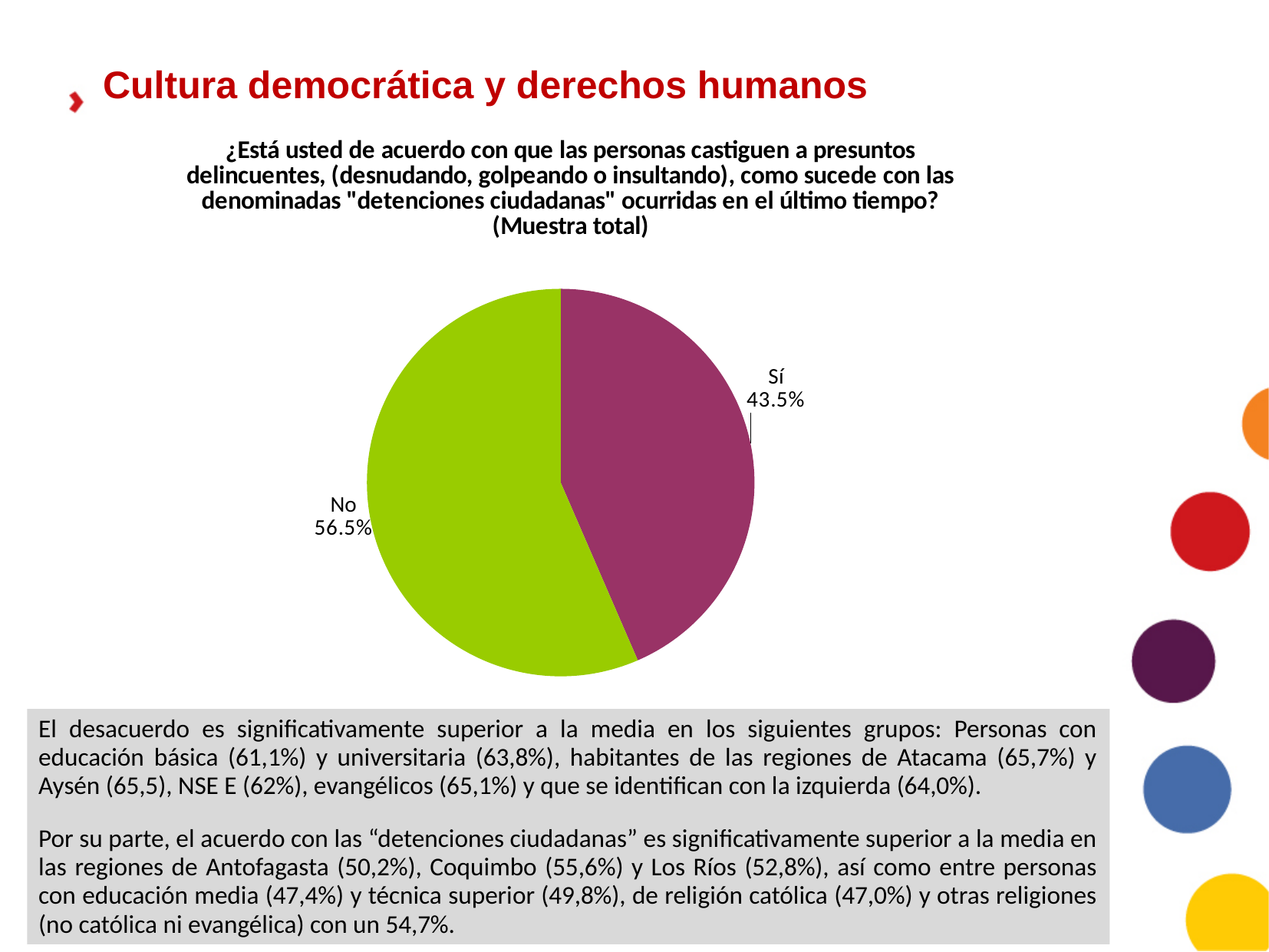
Is the value for "No" greater or less than 50%? greater What type of chart is shown on the slide? Pie chart How many slices does the pie chart have? 2 What percentage of respondents answered "Sí"? 43.5% Is the share for "Sí" larger or smaller than the share for "No"? Smaller Which response has the larger share of the pie? No What percentage of respondents answered "No"? 56.5% What is the total of the two slices shown in the pie chart? 100% What colour is the "Sí" slice of the pie chart? Magenta (purple-pink) What colour is the "No" slice of the pie chart? Green What is the difference in percentage points between the "No" and "Sí" slices? 13 percentage points Which response has the smaller share of the pie? Sí